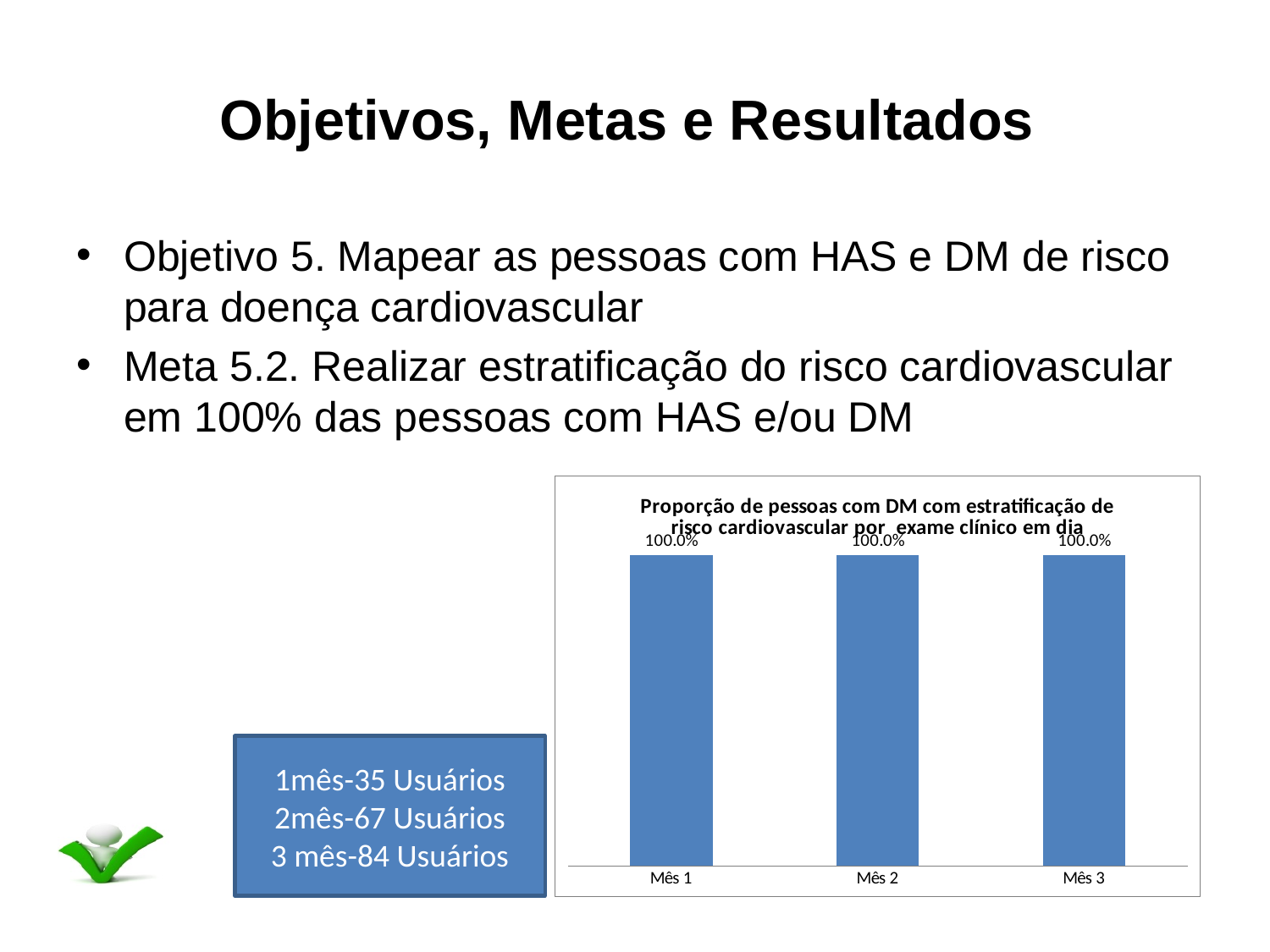
What is the value for Mês 3? 100.0% Is the value for Mês 2 larger than, smaller than, or equal to the value for Mês 1? equal What is the title of the chart? Proporção de pessoas com DM com estratificação de risco cardiovascular por exame clínico em dia What is the difference between the values for Mês 3 and Mês 1? 0.0% What is the value for Mês 1? 100.0% What is the value for Mês 2? 100.0% Do the values rise, fall or stay the same from Mês 1 to Mês 3? stay the same What kind of chart is shown on the slide? bar chart What colour are the bars in the chart? blue How many categories are shown on the x axis of the chart? 3